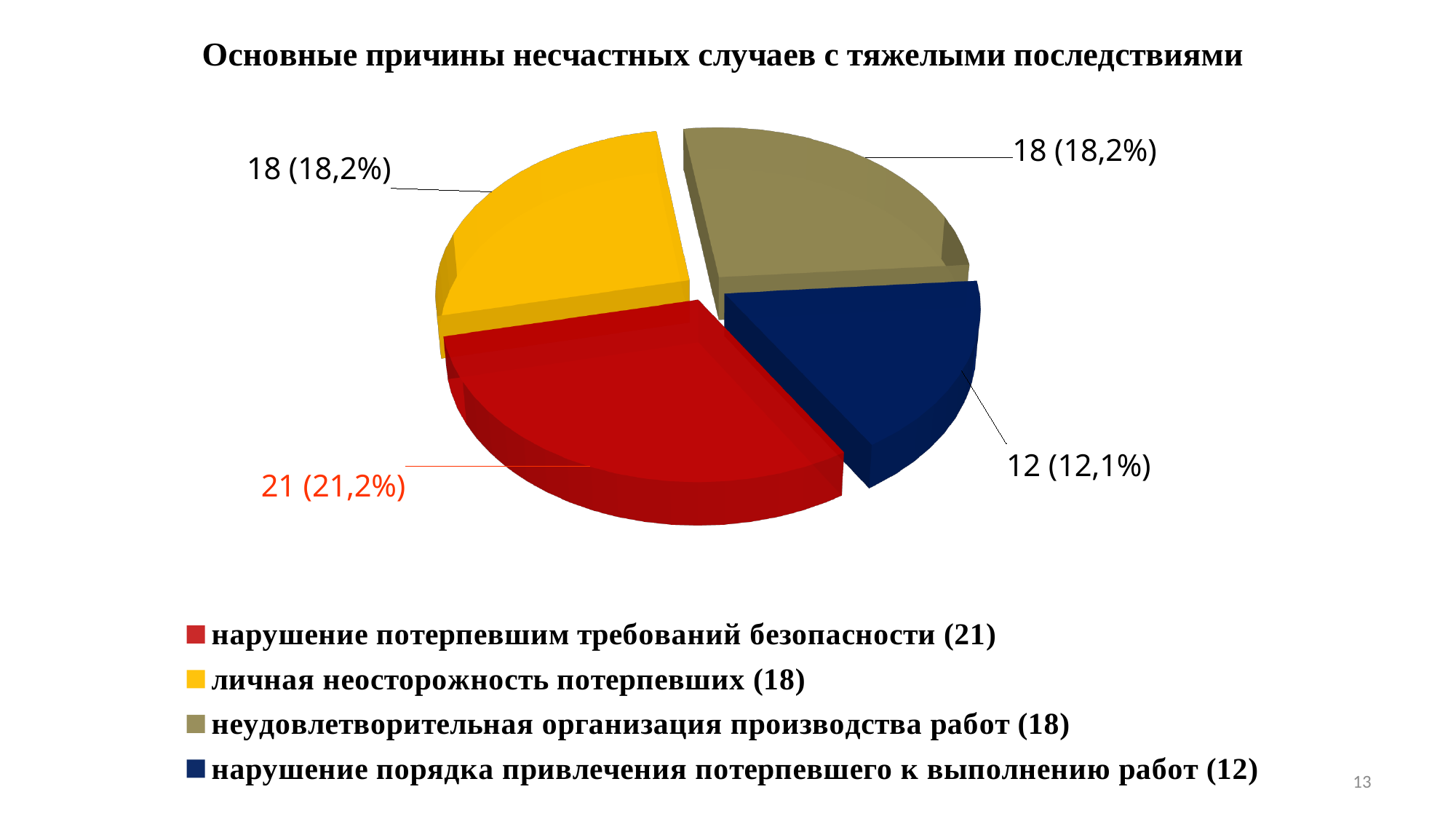
Which category has the largest slice? нарушение потерпевшим требований безопасности What percentage share is shown for the slice «нарушение потерпевшим требований безопасности»? 21,2% Which is larger: the value for «личная неосторожность потерпевших» or for «нарушение порядка привлечения потерпевшего к выполнению работ»? личная неосторожность потерпевших What is the value for «нарушение порядка привлечения потерпевшего к выполнению работ»? 12 What is the value for «личная неосторожность потерпевших»? 18 What is the difference between the values for «нарушение потерпевшим требований безопасности» and «нарушение порядка привлечения потерпевшего к выполнению работ»? 9 Which category has the smallest slice? нарушение порядка привлечения потерпевшего к выполнению работ What kind of chart is shown on the slide? pie chart How many slices does the pie chart have? 4 What colour is the slice for «неудовлетворительная организация производства работ»? olive (khaki) What percentage share is shown for the slice «нарушение порядка привлечения потерпевшего к выполнению работ»? 12,1% What is the value for «нарушение потерпевшим требований безопасности»? 21